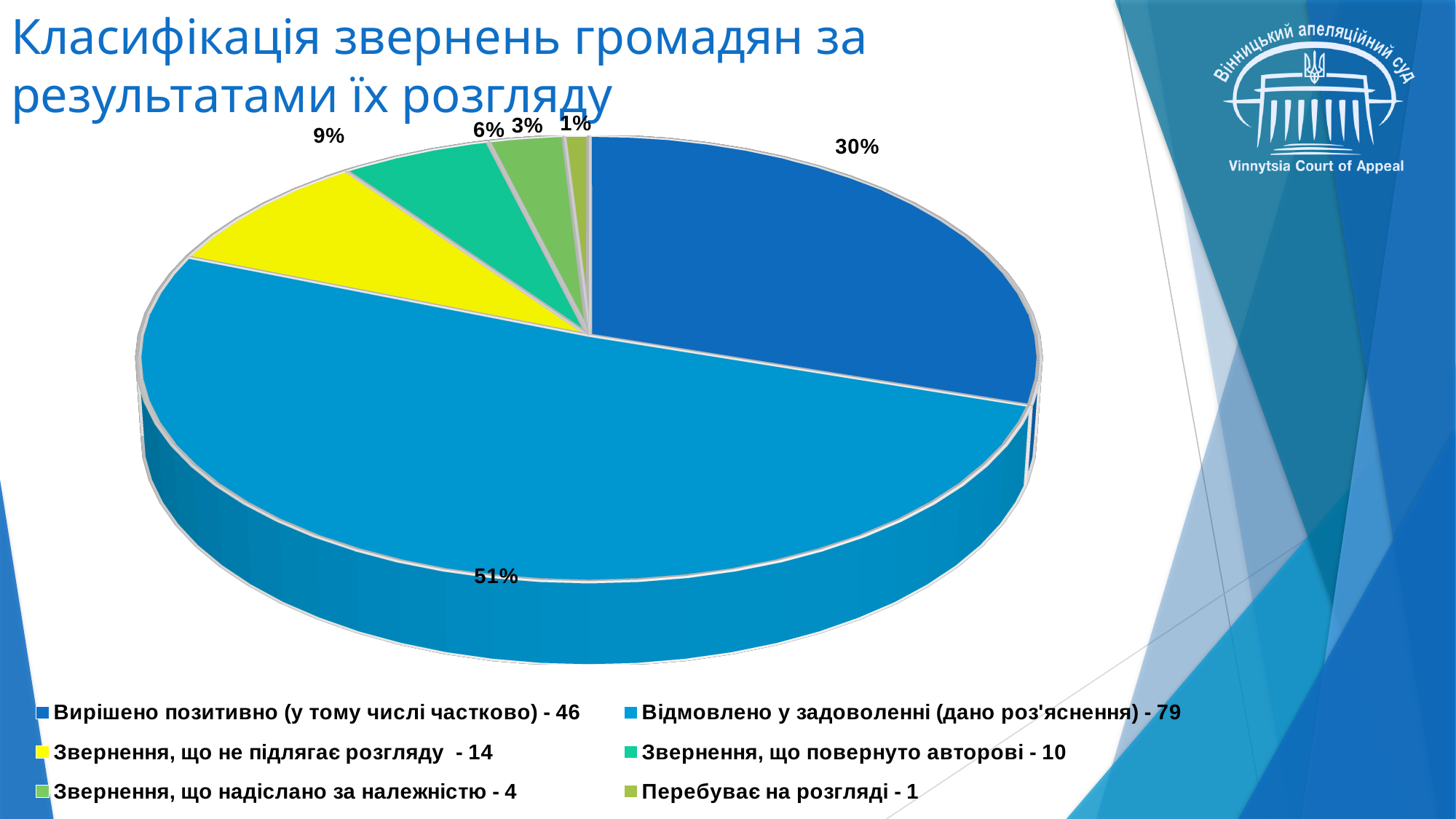
Which slice is larger: "Звернення, що не підлягає розгляду" or "Звернення, що повернуто авторові"? Звернення, що не підлягає розгляду What percentage share does the slice "Відмовлено у задоволенні (дано роз'яснення)" have? 51% Which category has the largest slice of the pie? Відмовлено у задоволенні (дано роз'яснення) How many categories does the pie chart show? 6 What percentage share does the slice "Вирішено позитивно (у тому числі частково)" have? 30% What is the difference in percentage points between the "Відмовлено у задоволенні" slice (51%) and the "Вирішено позитивно" slice (30%)? 21 percentage points What percentage share does the slice "Звернення, що повернуто авторові" have? 6% What number of appeals does the legend give for "Звернення, що надіслано за належністю"? 4 Which category has the smallest slice of the pie? Перебуває на розгляді What type of chart is shown on the slide? pie chart